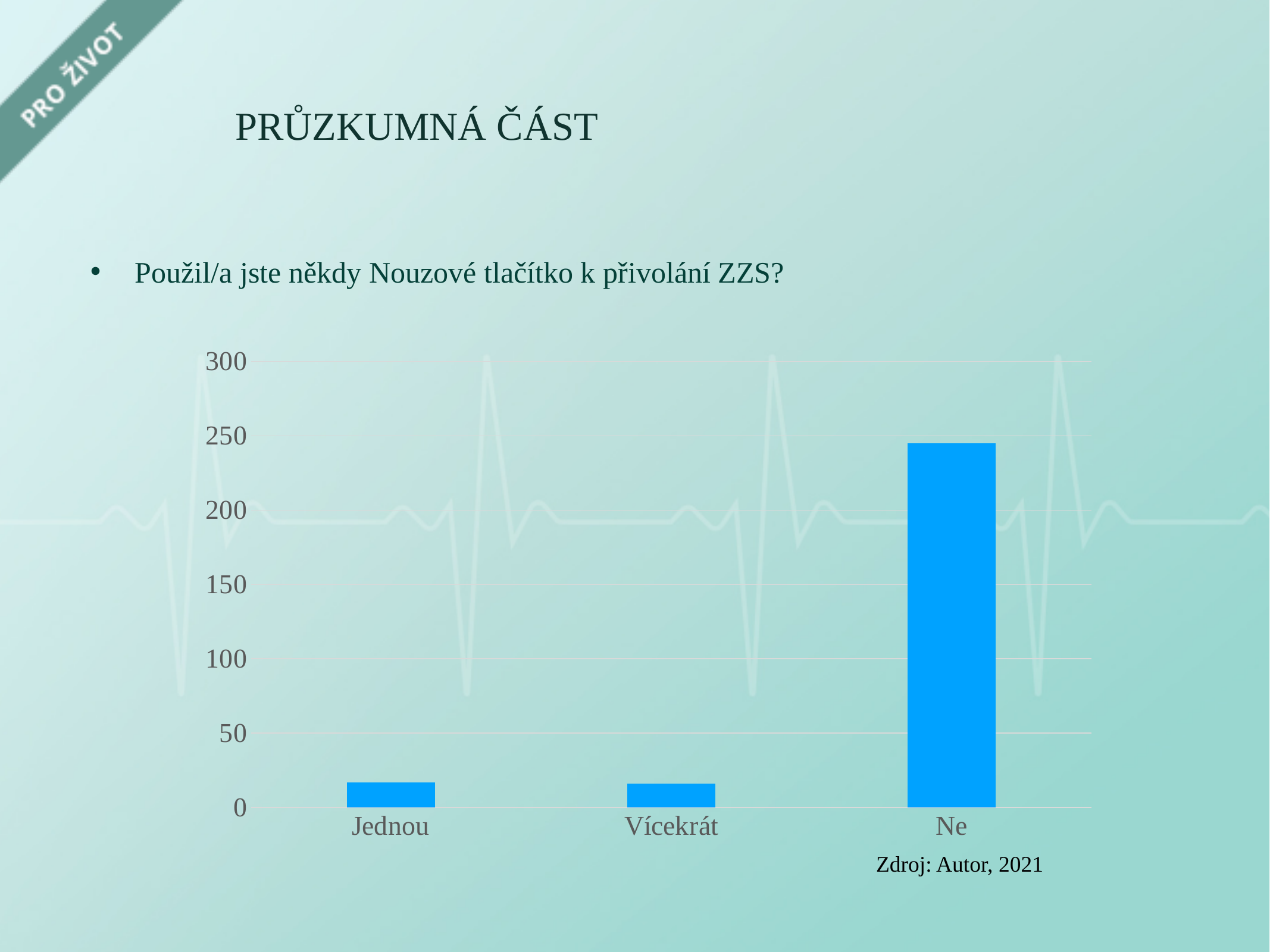
What source is cited below the chart? Zdroj: Autor, 2021 Is the value for Jednou greater or less than 50? less How many categories are shown on the x axis of the chart? 3 What kind of chart is shown on the slide? bar chart Is the value for Vícekrát greater or less than 50? less Which is larger, the value for Vícekrát or the value for Ne? Ne Which category has the highest value in the chart? Ne Is the value for Ne greater or less than 200? greater Which is larger, the value for Ne or the value for Jednou? Ne What is the highest value shown on the y axis of the chart? 300